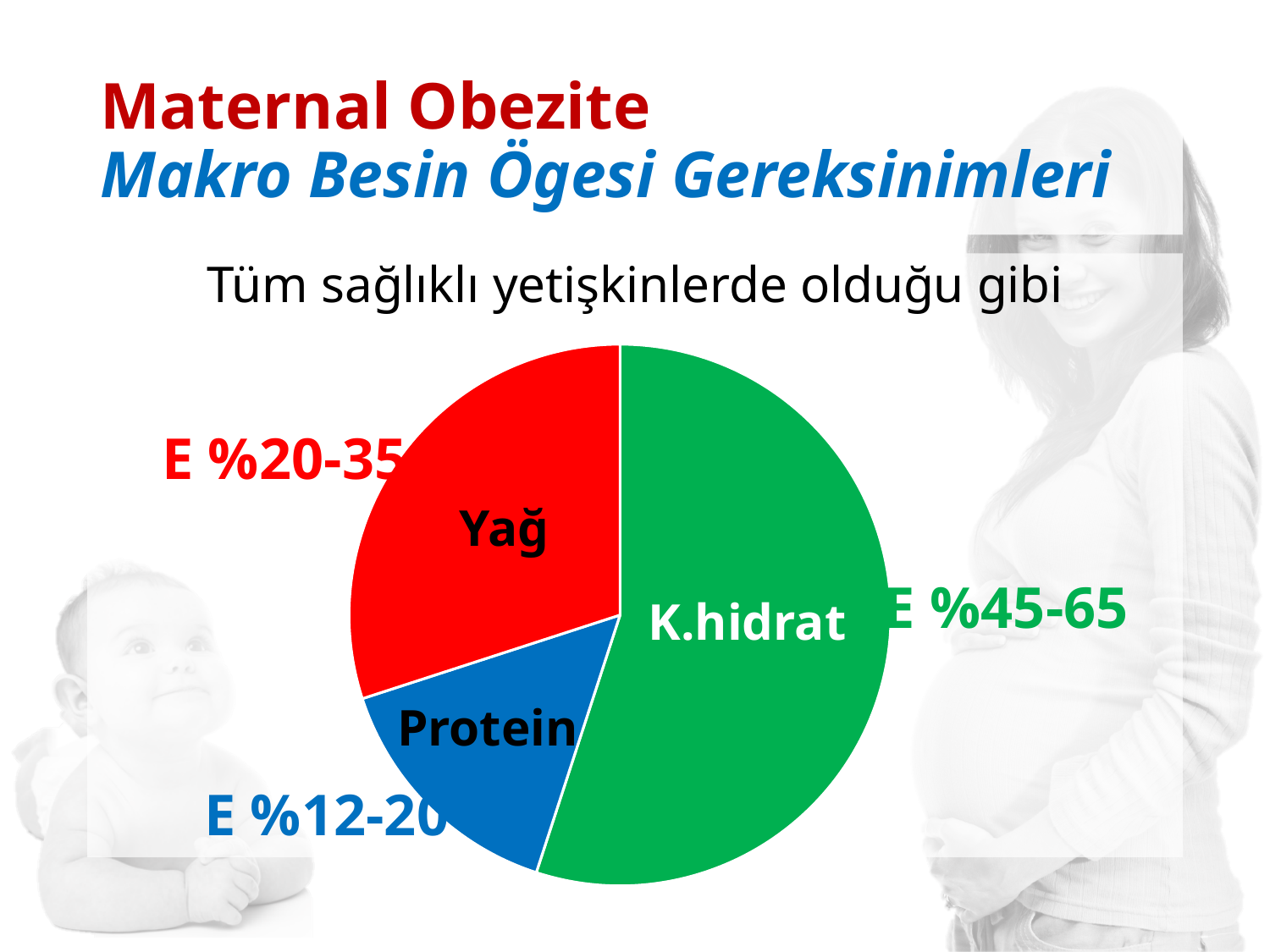
What colour is the K.hidrat slice? green What energy range is shown next to the Yağ slice? E %20-35 Which slice of the pie chart is the smallest? Protein Which slice is larger, Yağ or Protein? Yağ What colour is the Protein slice? blue What energy range is shown next to the K.hidrat slice? E %45-65 What energy range is shown next to the Protein slice? E %12-20 Which slice is larger, K.hidrat or Yağ? K.hidrat Which slice of the pie chart is the largest? K.hidrat How many slices does the pie chart have? 3 What kind of chart is shown on the slide? pie chart